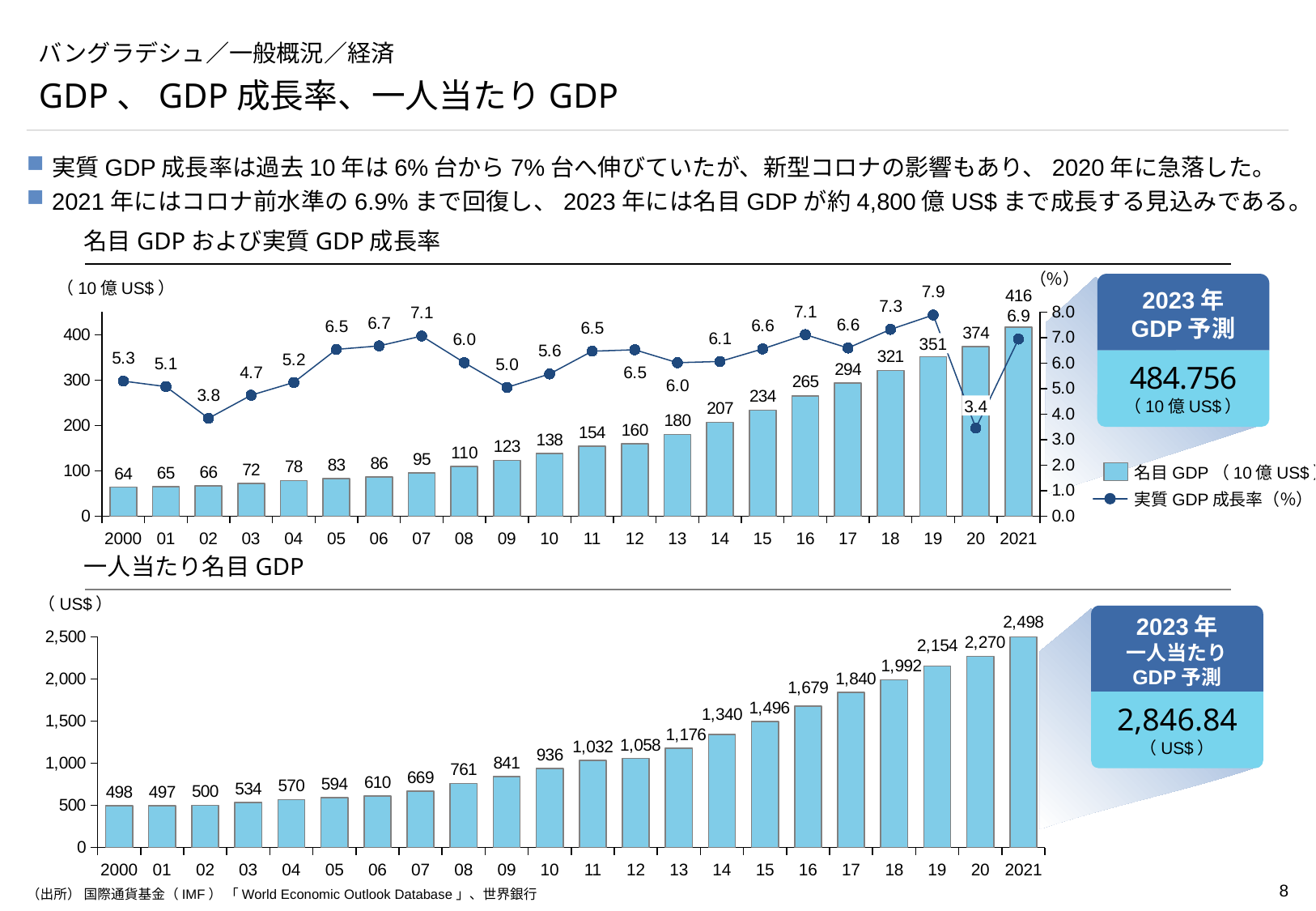
In the bottom chart (一人当たり名目GDP), do the values generally rise or fall from 2000 to 2021? rise In the top chart (名目GDPおよび実質GDP成長率), which year has the lowest real GDP growth rate? 2020 In the bottom chart (一人当たり名目GDP), what is the value for 2021? 2,498 In the top chart (名目GDPおよび実質GDP成長率), what is the nominal GDP value for 2021? 416 In the top chart (名目GDPおよび実質GDP成長率), which year has the higher real GDP growth rate, 2007 or 2008? 2007 What kind of chart is the bottom chart (一人当たり名目GDP)? bar chart In the top chart (名目GDPおよび実質GDP成長率), what is the real GDP growth rate for 2020? 3.4 In the top chart (名目GDPおよび実質GDP成長率), which year has the highest real GDP growth rate? 2019 In the top chart (名目GDPおよび実質GDP成長率), by how much did nominal GDP increase from 2020 to 2021? 42 How many years are plotted in the bottom chart (一人当たり名目GDP)? 22 How many series does the legend of the top chart (名目GDPおよび実質GDP成長率) list? 2 In the bottom chart (一人当たり名目GDP), which year has the highest value? 2021